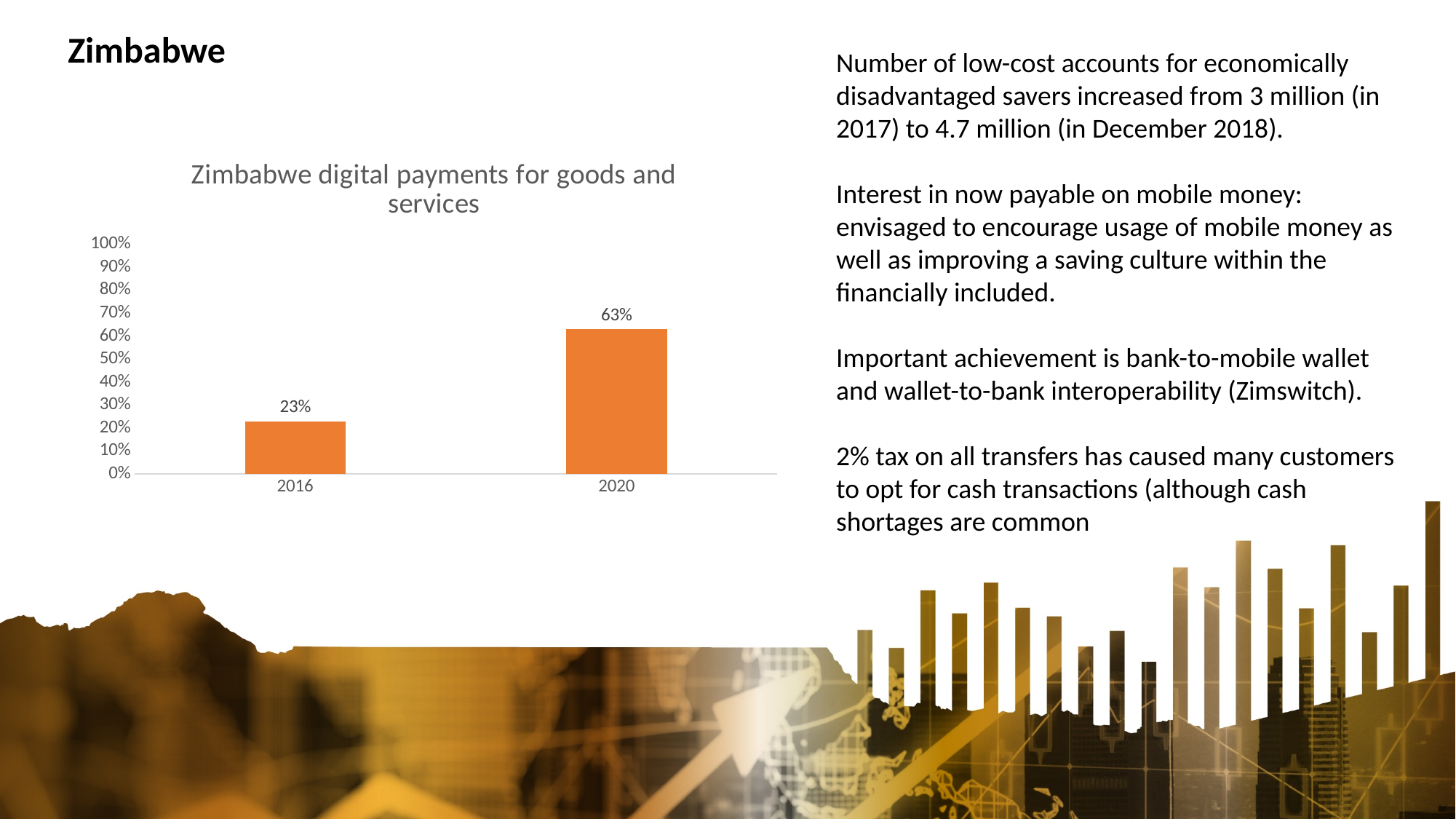
Is the value for 2020 greater or less than 50%? greater Which is larger, the value for 2016 or the value for 2020? 2020 Do the values rise or fall from 2016 to 2020? rise How many years are shown on the x axis? 2 What is the value for 2016? 23% Which year has the highest value? 2020 What is the difference between the values for 2020 and 2016? 40% What is the value for 2020? 63% What is the title of the chart? Zimbabwe digital payments for goods and services Which year has the lowest value? 2016 What kind of chart is shown? bar chart Is the value for 2016 greater or less than 30%? less